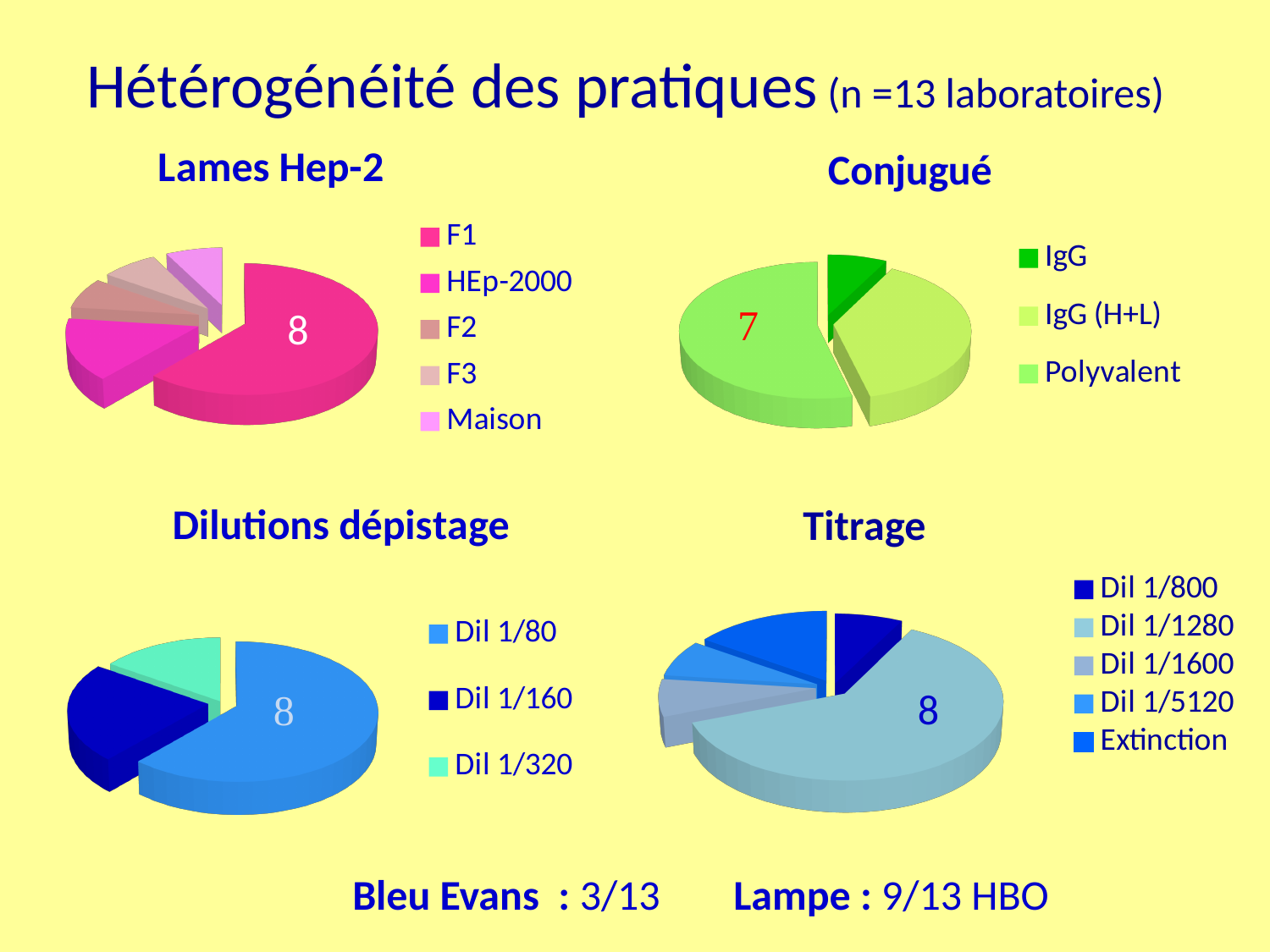
In the Titrage chart, which category has the largest slice? Dil 1/1280 In the Conjugué chart, what value is shown for the Polyvalent slice? 7 In the Lames Hep-2 chart, what value is shown for the F1 slice? 8 In the Lames Hep-2 chart, which slice is larger: F1 or HEp-2000? F1 In the Conjugué chart, which category has the smallest slice? IgG What type of chart is the Conjugué chart? Pie chart In the Conjugué chart, which slice is larger: IgG or Polyvalent? Polyvalent In the Dilutions dépistage chart, what value is shown for the Dil 1/80 slice? 8 In the Lames Hep-2 chart, which category has the largest slice? F1 How many categories does the legend of the Titrage chart list? 5 In the Titrage chart, what value is shown for the Dil 1/1280 slice? 8 How many categories does the legend of the Dilutions dépistage chart list? 3